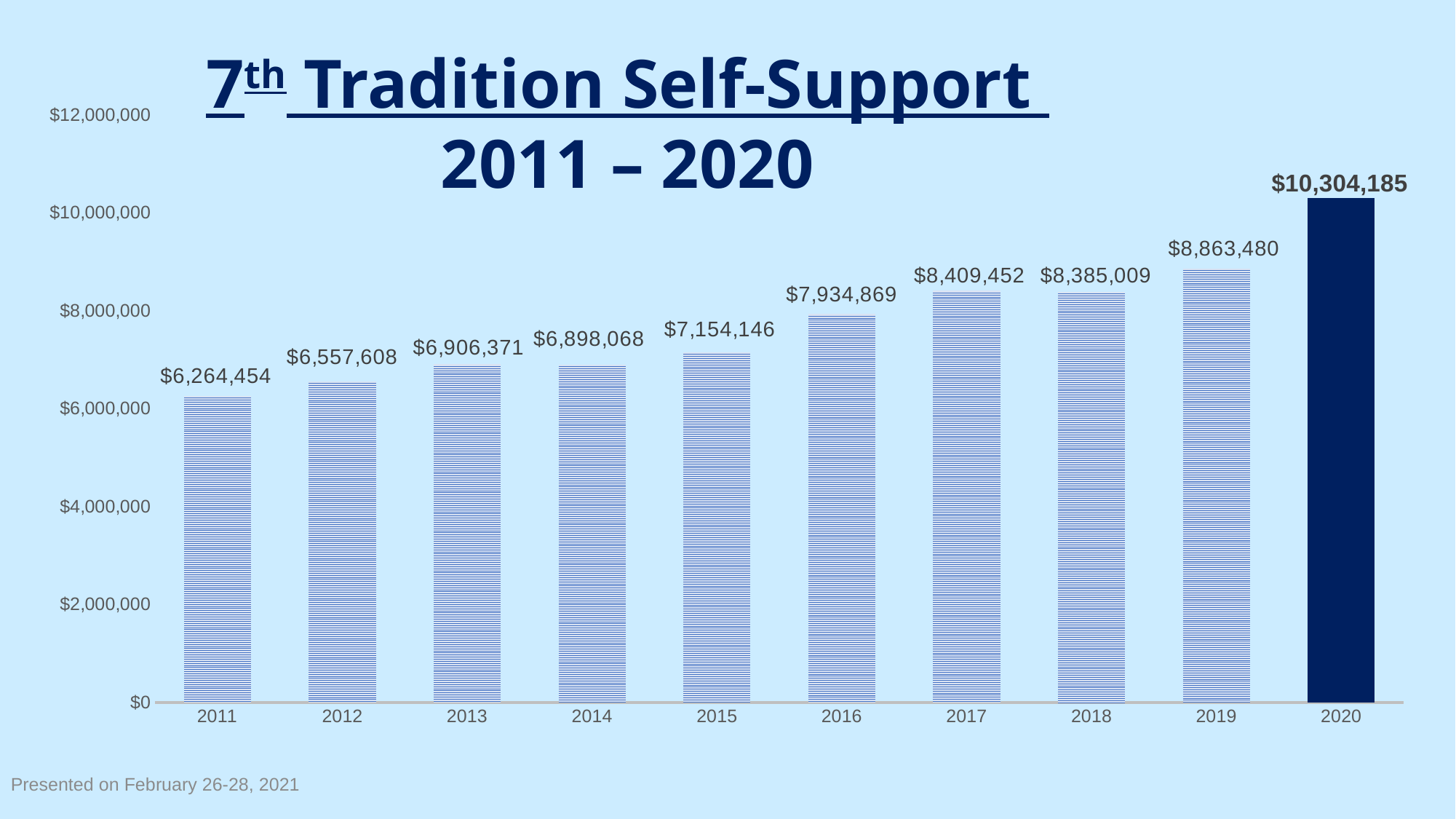
What is the value for 2015? $7,154,146 Do the values generally rise or fall from 2011 to 2020? rise Which is larger, the value for 2016 or the value for 2015? 2016 What is the difference between the values for 2012 and 2011? $293,154 What is the difference between the values for 2020 and 2019? $1,440,705 What kind of chart is shown on the slide? bar chart What is the value for 2020? $10,304,185 Which year has the highest value? 2020 Which year has the lowest value? 2011 Is the value for 2019 greater or less than $8,000,000? greater What is the value for 2011? $6,264,454 How many years are shown on the x axis? 10